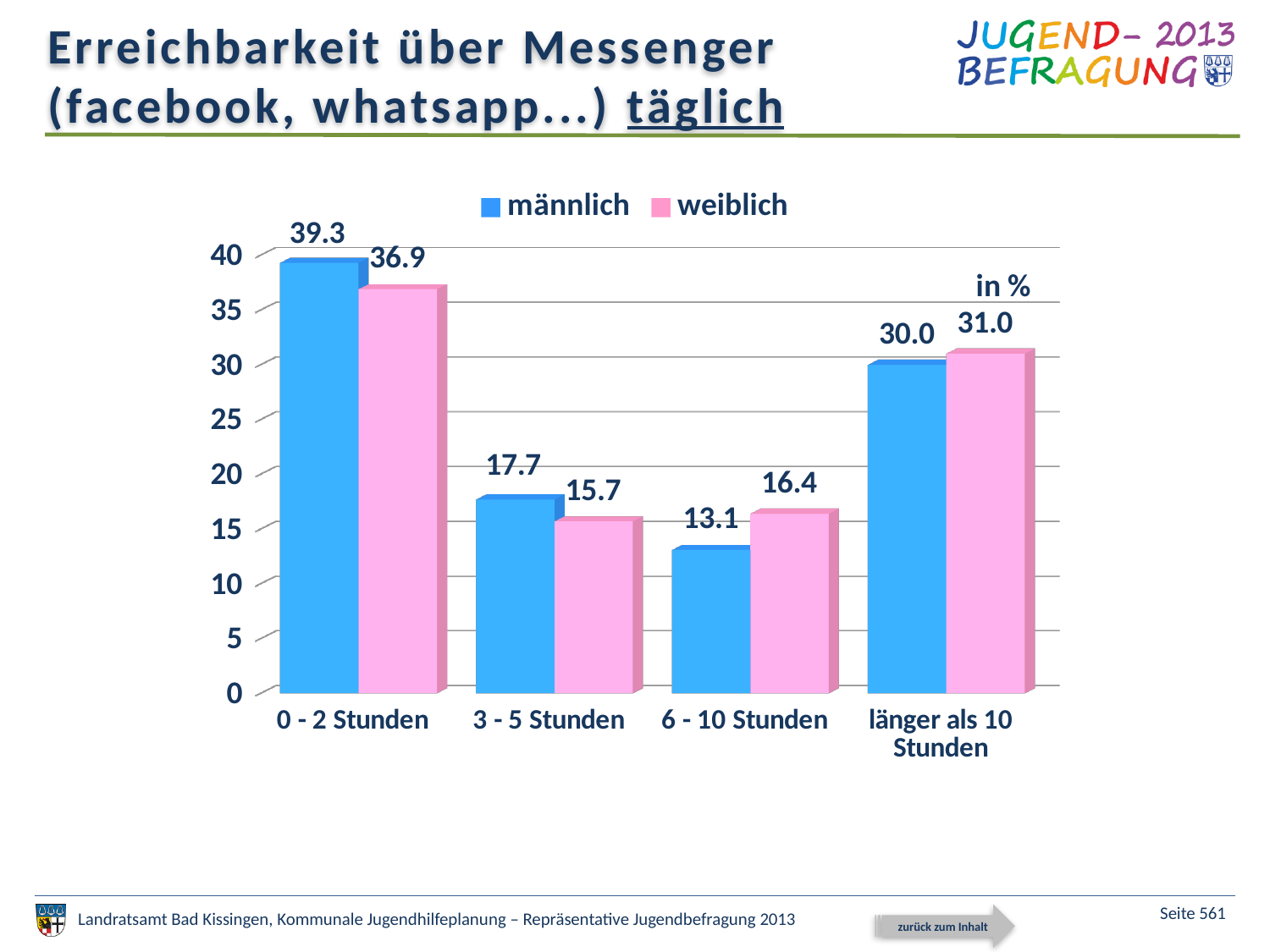
How many categories are shown on the x axis? 4 Which category has the highest value for männlich? 0 - 2 Stunden What is the value for weiblich in the länger als 10 Stunden category? 31.0 What unit is indicated for the values in the chart? % What is the value for weiblich in the 6 - 10 Stunden category? 16.4 In the 6 - 10 Stunden category, which series has the larger value, männlich or weiblich? weiblich What is the value for männlich in the 0 - 2 Stunden category? 39.3 Which category has the lowest value for weiblich? 3 - 5 Stunden What is the difference between the männlich and weiblich values in the 0 - 2 Stunden category? 2.4 What kind of chart is shown on the slide? bar chart How many series does the legend list? 2 Is the value for männlich in the 3 - 5 Stunden category greater or less than 20? less